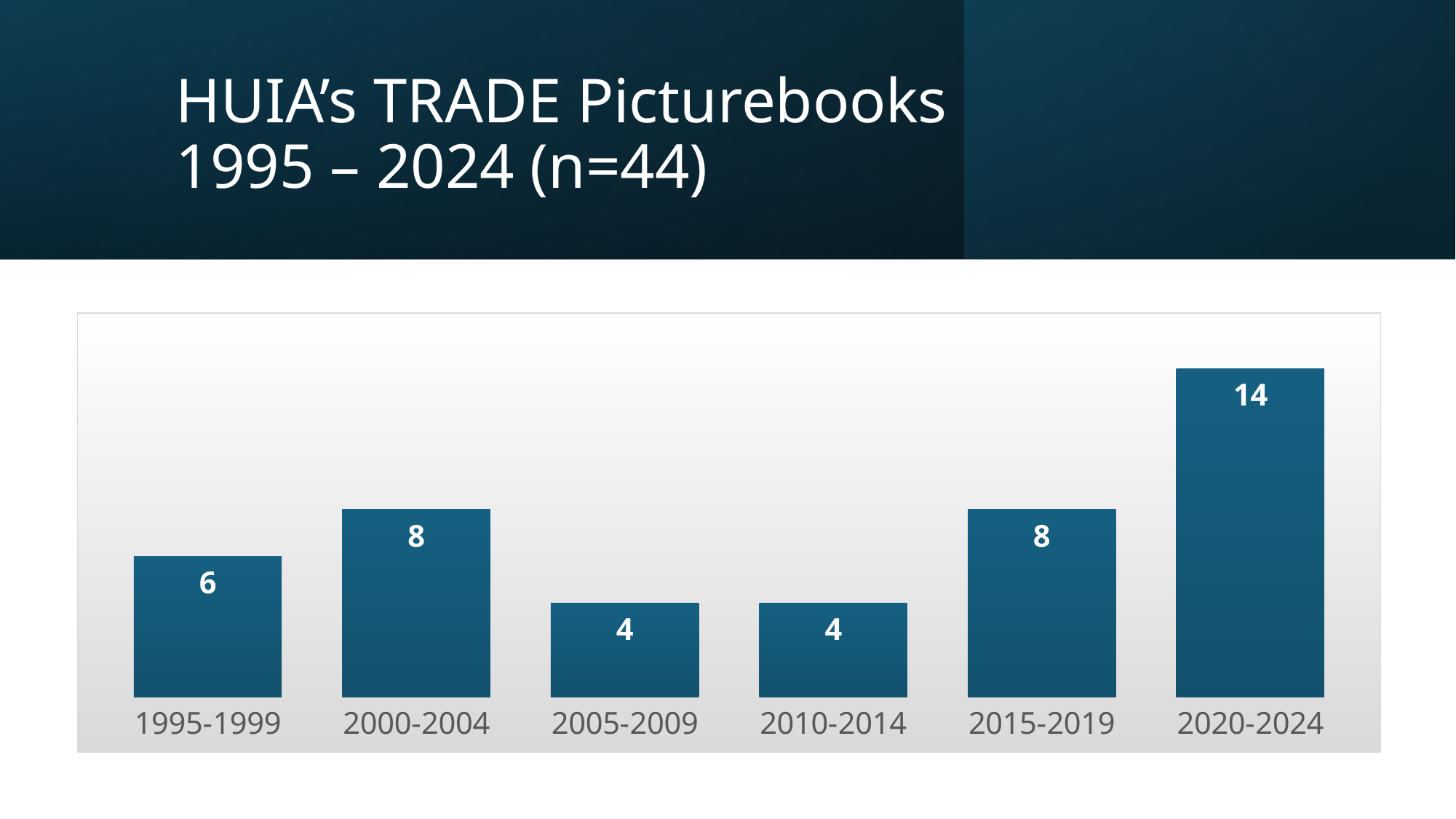
What is the value for 1995-1999? 6 What is the title of the slide? HUIA's TRADE Picturebooks 1995 – 2024 (n=44) Which is larger, the value for 1995-1999 or the value for 2005-2009? 1995-1999 What is the value for 2020-2024? 14 What is the value for 2005-2009? 4 How many periods are shown on the x axis? 6 What kind of chart is shown on the slide? bar chart Which period has the highest value? 2020-2024 What is the difference between the values for 2000-2004 and 1995-1999? 2 What is the difference between the values for 2020-2024 and 2015-2019? 6 Which two periods share the same value of 8? 2000-2004 and 2015-2019 Do the values rise or fall from 2010-2014 to 2020-2024? rise